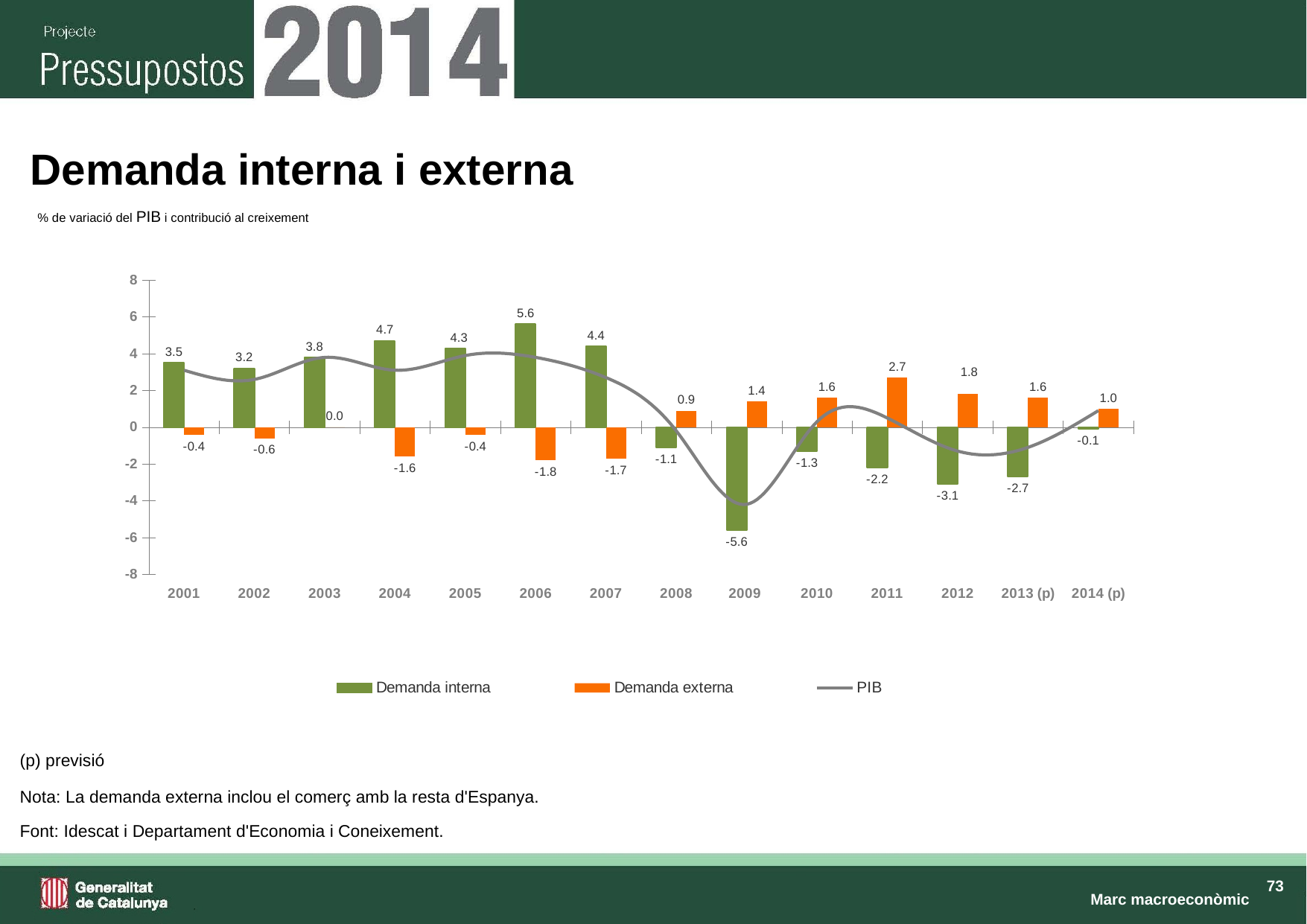
Which is larger, Demanda externa in 2012 or in 2013 (p)? 2012 In which year is Demanda externa highest? 2011 What is the value of Demanda interna in 2014 (p)? -0.1 How many years are shown on the x axis? 14 Is the PIB line value for 2009 greater or less than -2? less What kind of chart is shown on the slide? A combined bar and line chart In which year is Demanda interna highest? 2006 What is the value of Demanda externa in 2011? 2.7 In which year is Demanda interna lowest? 2009 How many series does the legend list? 3 What is the difference between Demanda interna in 2004 and in 2005? 0.4 What is the value of Demanda interna in 2006? 5.6